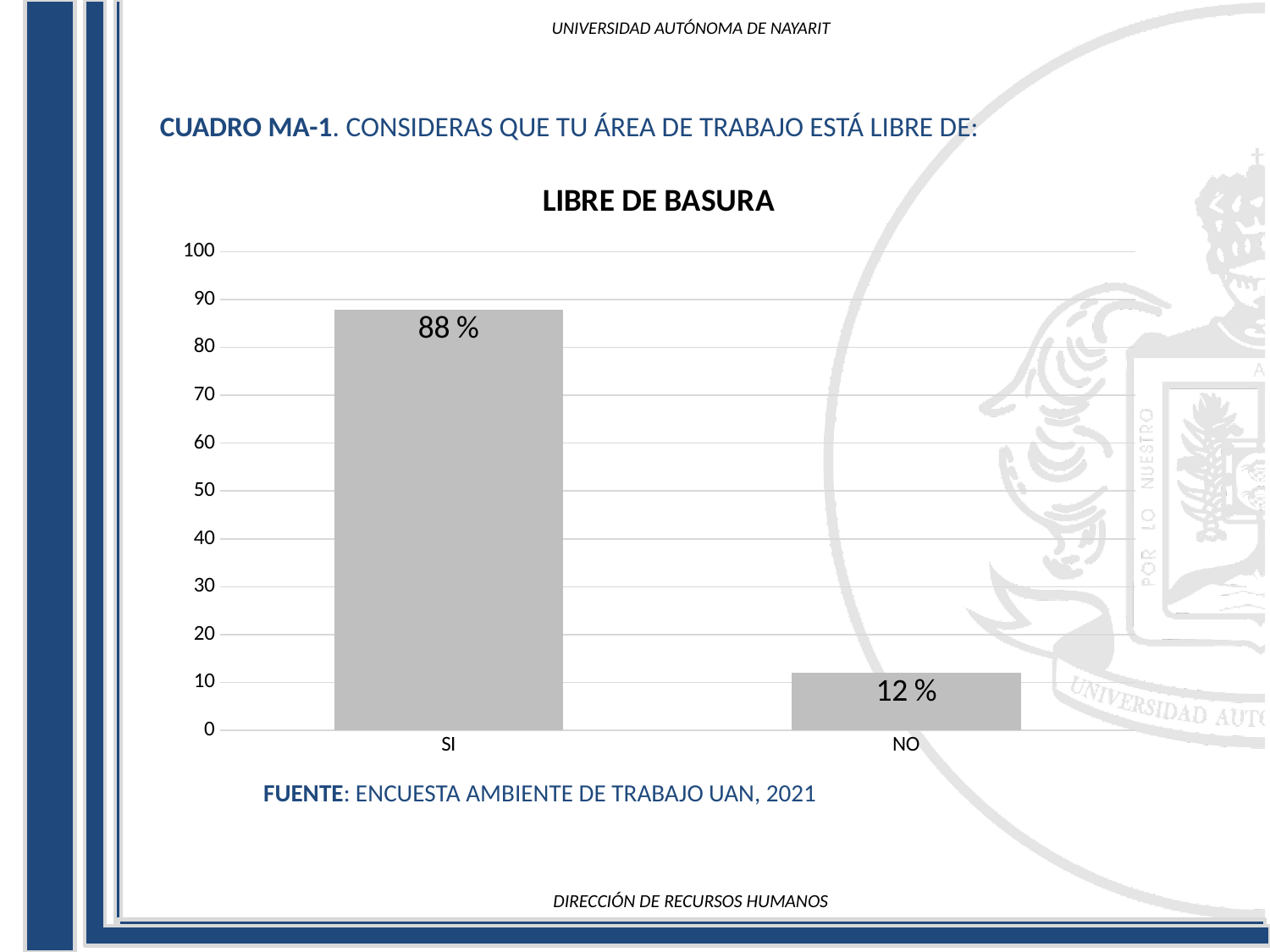
Which category has the lowest value? NO What is the highest value shown on the y axis? 100 Is the value for NO greater or less than 20? less What is the difference between the values for SI and NO? 76 % Which category has the highest value? SI What is the title of the chart? LIBRE DE BASURA Is the value for SI greater or less than 80? greater What is the value for SI? 88 % Which is larger, the value for SI or the value for NO? SI What is the value for NO? 12 % How many categories are shown on the x axis? 2 What kind of chart is shown? bar chart